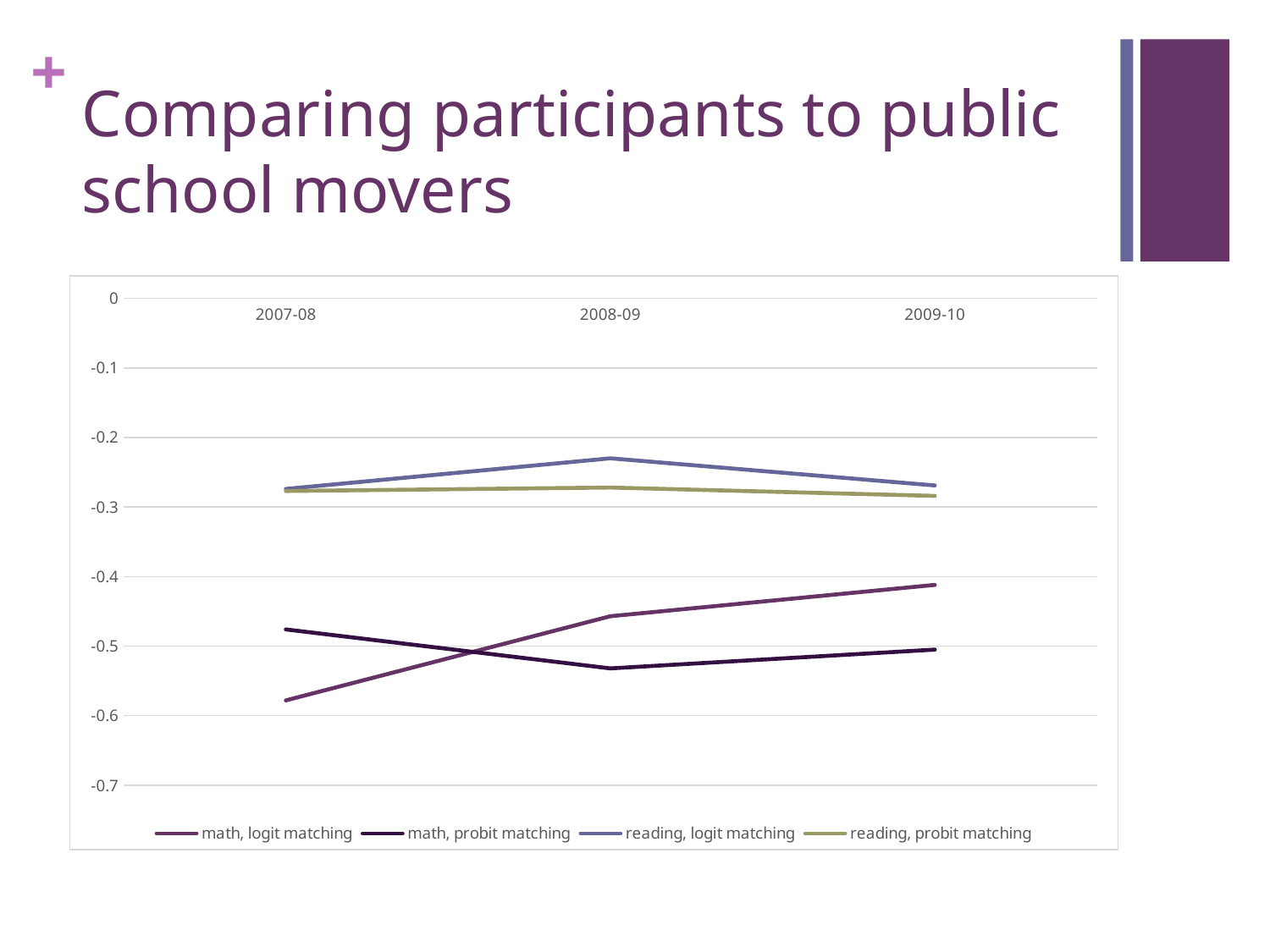
Is the value for math, logit matching in 2007-08 greater or less than -0.5? less Which series is plotted with the green line? reading, probit matching Is the value for math, logit matching in 2009-10 greater or less than -0.5? greater How many school years are shown along the x axis? 3 In 2009-10, which is larger: math, logit matching or math, probit matching? math, logit matching Does the math, logit matching line rise or fall from 2007-08 to 2009-10? rise Which series has the highest value in 2008-09? reading, logit matching What is the title of the slide containing the chart? Comparing participants to public school movers What kind of chart is shown on the slide? line chart How many series does the legend list? 4 Which series has the lowest value in 2007-08? math, logit matching Is the value for reading, logit matching in 2008-09 greater or less than -0.3? greater